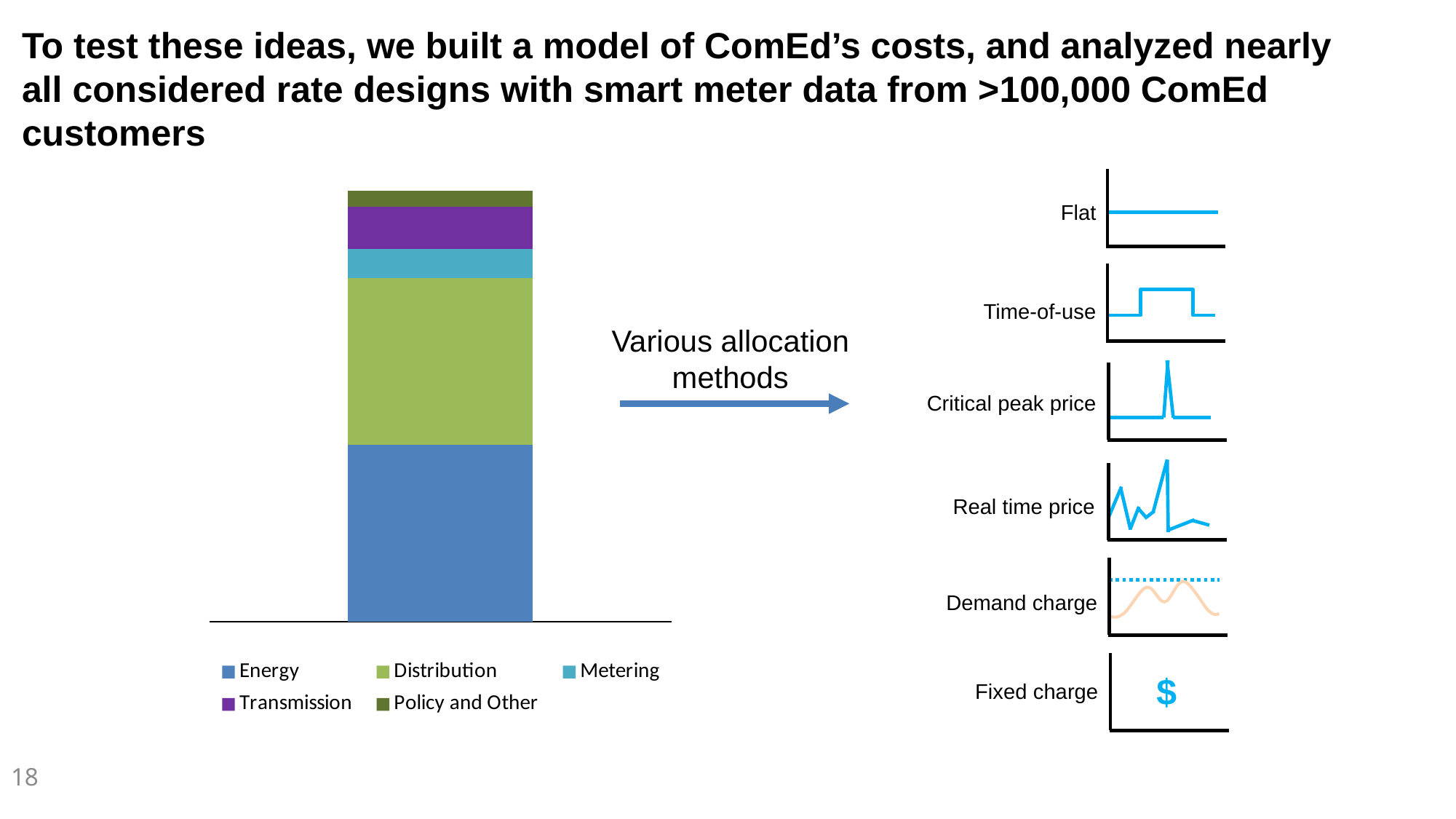
Which series makes up the smallest segment of the stacked bar? Policy and Other Which series is shown at the bottom of the stacked bar? Energy Which series in the stacked bar chart is shown in purple? Transmission In the stacked bar, which segment is larger: Transmission or Metering? Transmission In the stacked bar, which segment is larger: Metering or Policy and Other? Metering In the stacked bar, which segment is larger: Distribution or Transmission? Distribution How many series does the legend of the stacked bar chart list? 5 Which series makes up the largest segment of the stacked bar? Energy What kind of chart is shown on the left of the slide? stacked bar chart How many bars are plotted in the stacked bar chart? 1